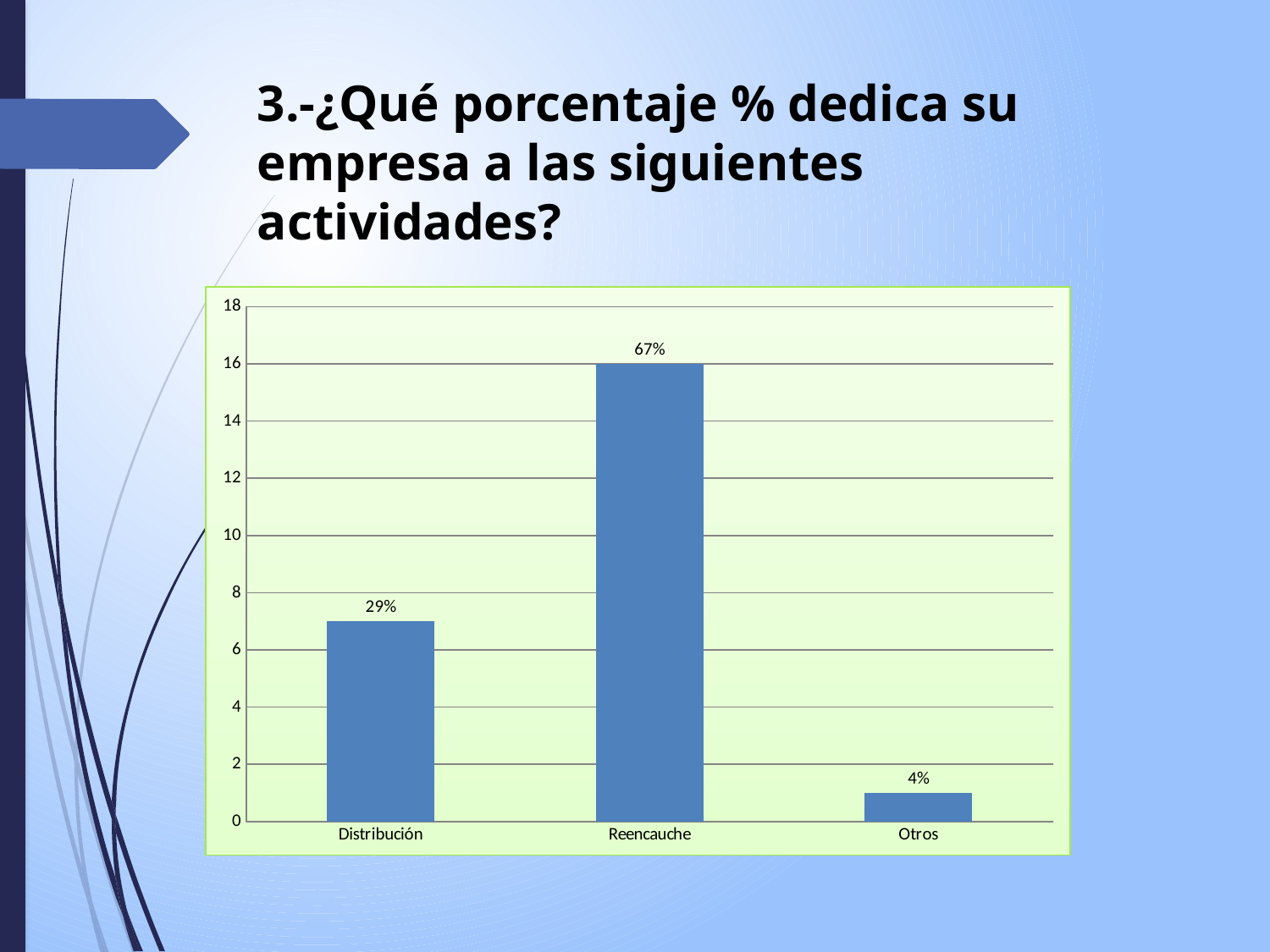
What is the data label shown on the Distribución bar? 29% Which category has the lowest bar? Otros What is the difference between the percentage labels for Distribución and Otros? 25% Which is larger, the bar for Distribución or the bar for Otros? Distribución What is the data label shown on the Otros bar? 4% How many categories are shown on the x axis? 3 Which category has the highest bar? Reencauche What is the difference between the percentage labels for Reencauche and Distribución? 38% What is the data label shown on the Reencauche bar? 67% What kind of chart is shown on the slide? Bar chart Is the value for Distribución on the vertical axis greater or less than 6? greater Is the value for Otros on the vertical axis greater or less than 2? less